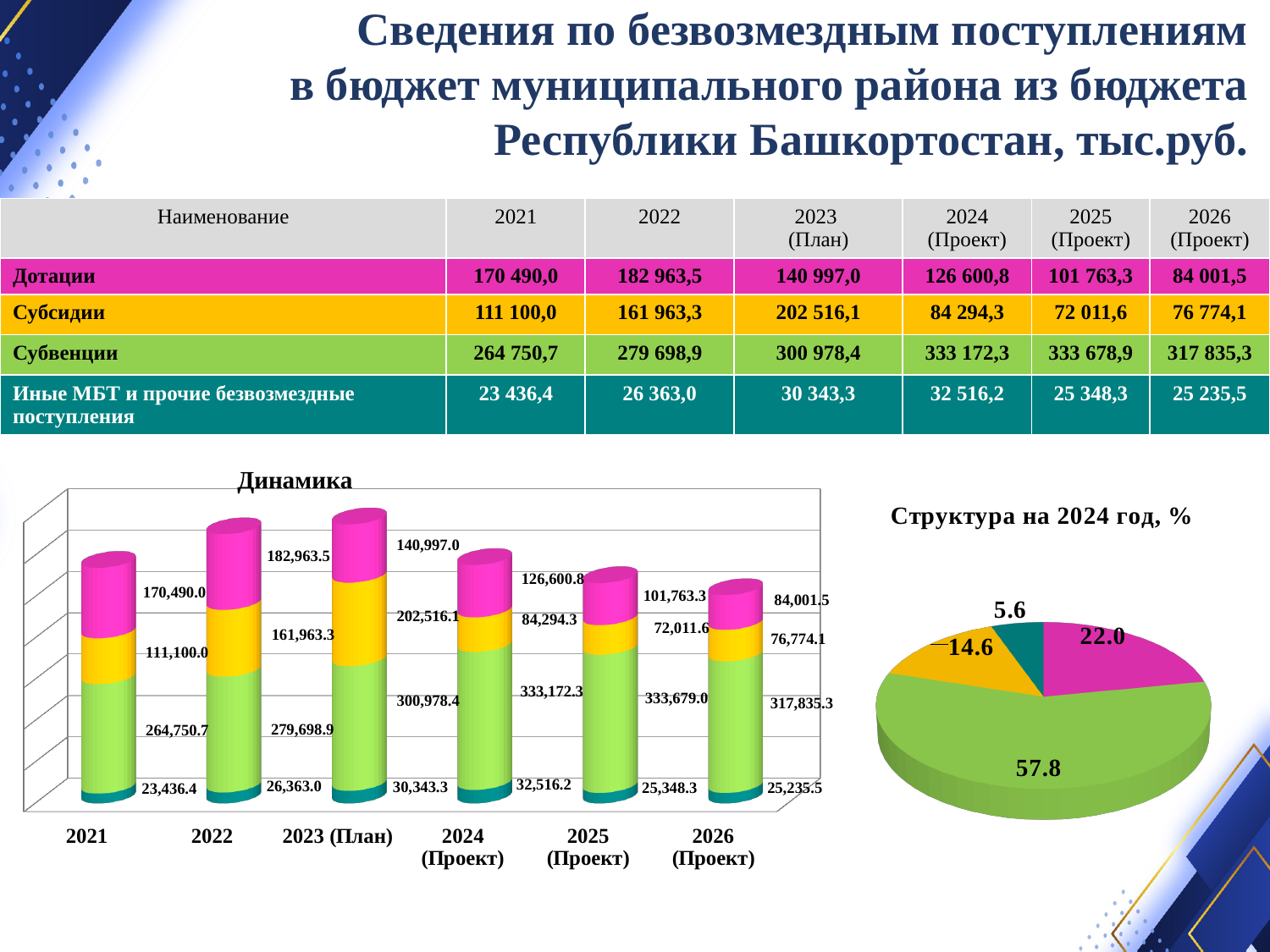
In the "Структура на 2024 год, %" pie chart, what is the value of the largest slice? 57.8 In the "Динамика" chart, what is the difference between the pink segment values for 2022 and 2021? 12,473.5 What kind of chart is the "Структура на 2024 год, %" chart on the right? Pie chart In the "Динамика" chart, which year has the smallest teal (bottom) segment? 2021 What kind of chart is the "Динамика" chart on the left? Stacked bar chart In the "Динамика" chart, what is the total of the stacked bar for 2021? 569,777.1 In the "Динамика" chart, which year has the largest pink (top) segment? 2022 In the "Динамика" chart, how many years (categories) are shown on the x axis? 6 In the "Структура на 2024 год, %" pie chart, how many slices are there? 4 In the "Динамика" chart, what is the value of the pink (top) segment for 2021? 170,490.0 In the "Динамика" chart, is the yellow segment larger in 2023 (План) or in 2024 (Проект)? 2023 (План) In the "Динамика" chart, what is the value of the green segment for 2023 (План)? 300,978.4